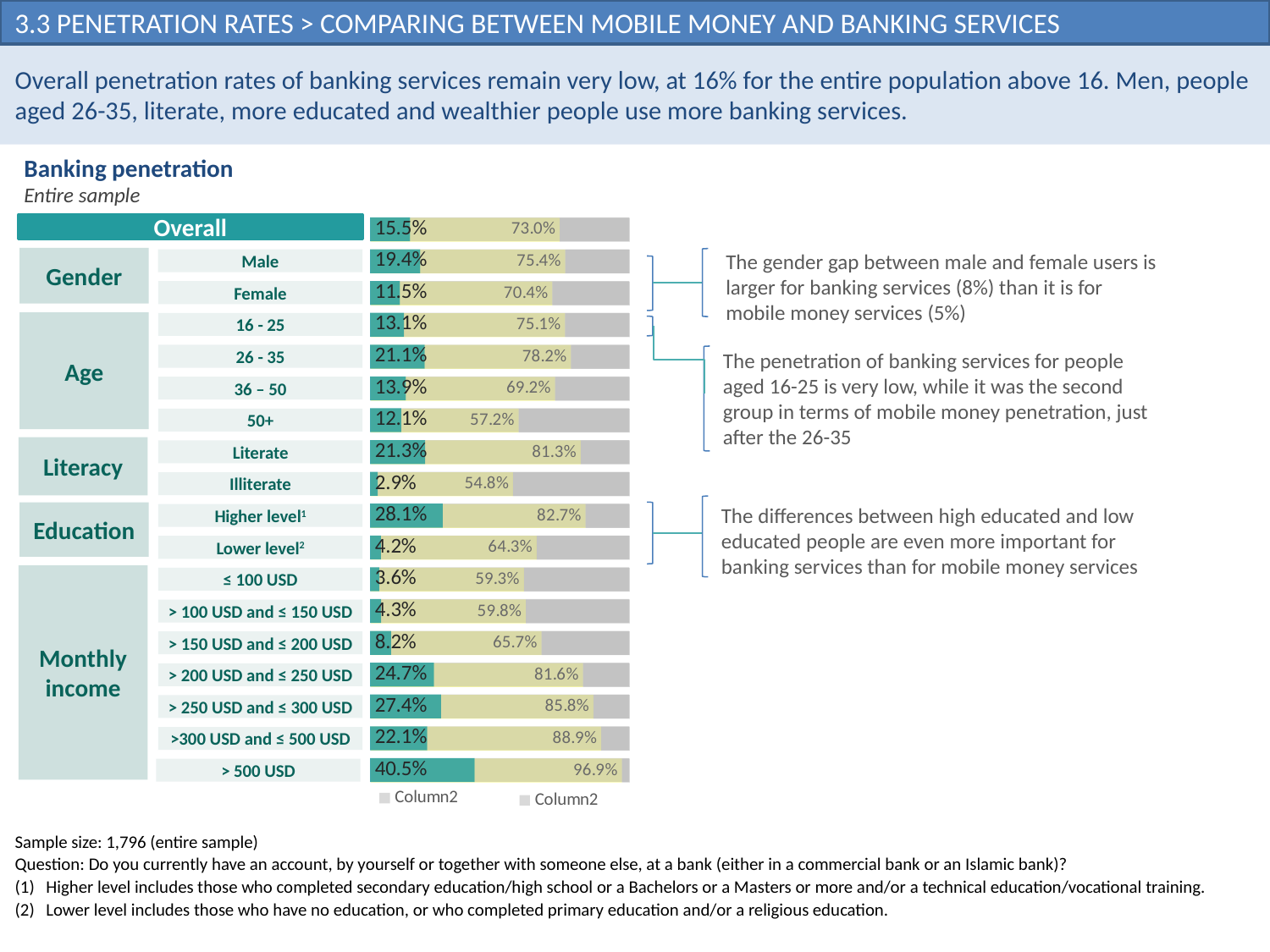
How many category rows are plotted in the chart? 18 What is the value shown on the yellow bar for the 26 - 35 age group? 78.2% Which has a larger teal bar value, the 16 - 25 age group or the 36 – 50 age group? 36 – 50 Which category has the highest teal bar value in the chart? > 500 USD Which category has the lowest teal bar value in the chart? Illiterate What is the value shown on the teal bar for Female? 11.5% What is the difference between the teal bar values for Male and Female? 7.9% What is the banking penetration value (teal bar) for the Overall row? 15.5% What is the difference between the teal bar values for Higher level and Lower level education? 23.9% What kind of chart is shown on the slide? Bar chart How many series does the legend list? 2 What is the teal bar value for the Illiterate category? 2.9%